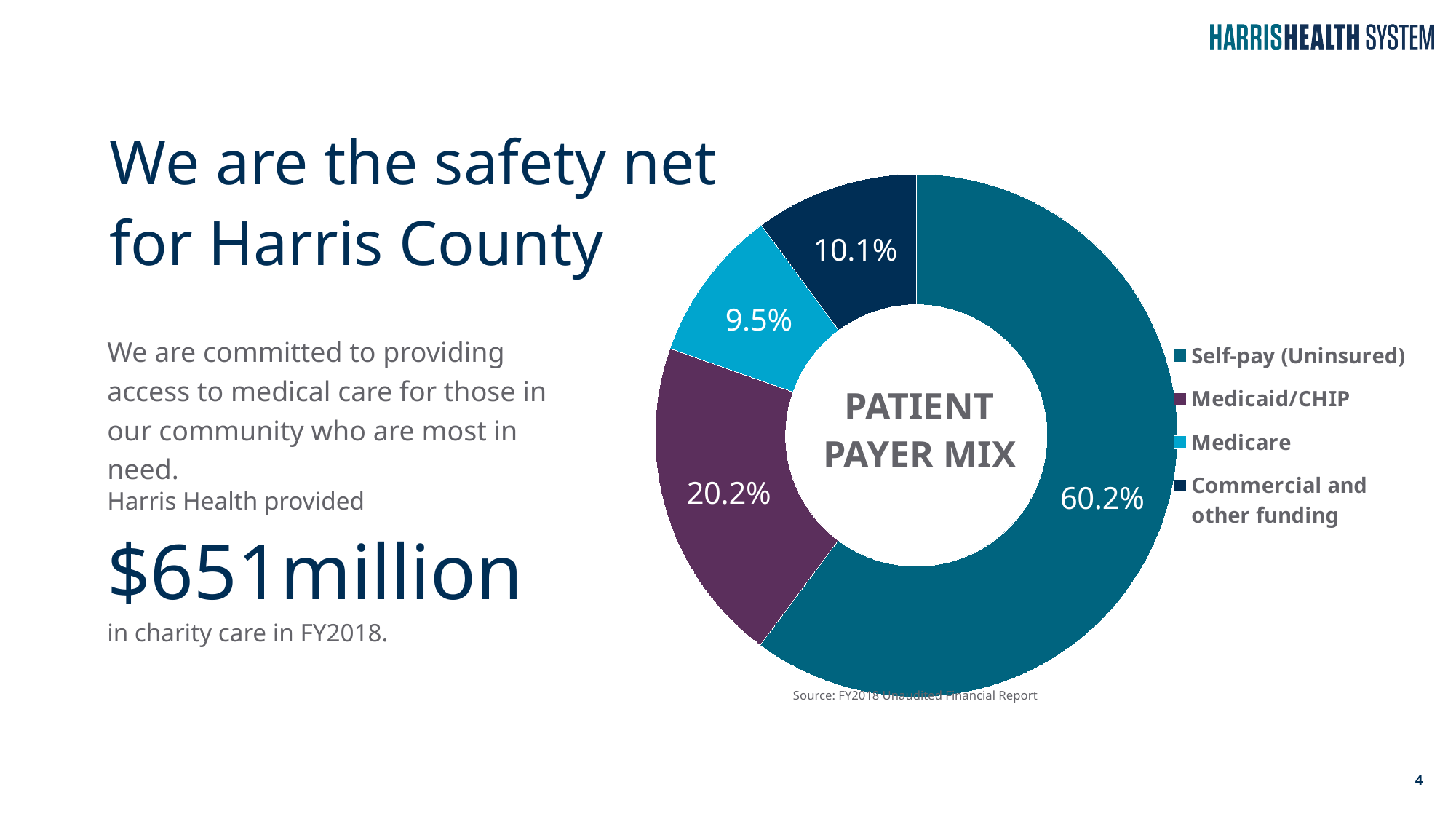
What source is cited below the patient payer mix chart? FY2018 Unaudited Financial Report What is the title shown in the centre of the chart? PATIENT PAYER MIX What share of the patient payer mix is Self-pay (Uninsured)? 60.2% What is the difference in percentage points between the Self-pay (Uninsured) share and the Medicaid/CHIP share? 40 percentage points What share of the patient payer mix is Medicaid/CHIP? 20.2% Which payer category has the smallest share of the patient payer mix? Medicare What share of the patient payer mix is Commercial and other funding? 10.1% Which payer category has the largest share of the patient payer mix? Self-pay (Uninsured) How many payer categories are shown in the patient payer mix chart? 4 What kind of chart is used to show the patient payer mix? Pie (doughnut) chart Which is larger, the Medicare share or the Commercial and other funding share? Commercial and other funding What share of the patient payer mix is Medicare? 9.5%